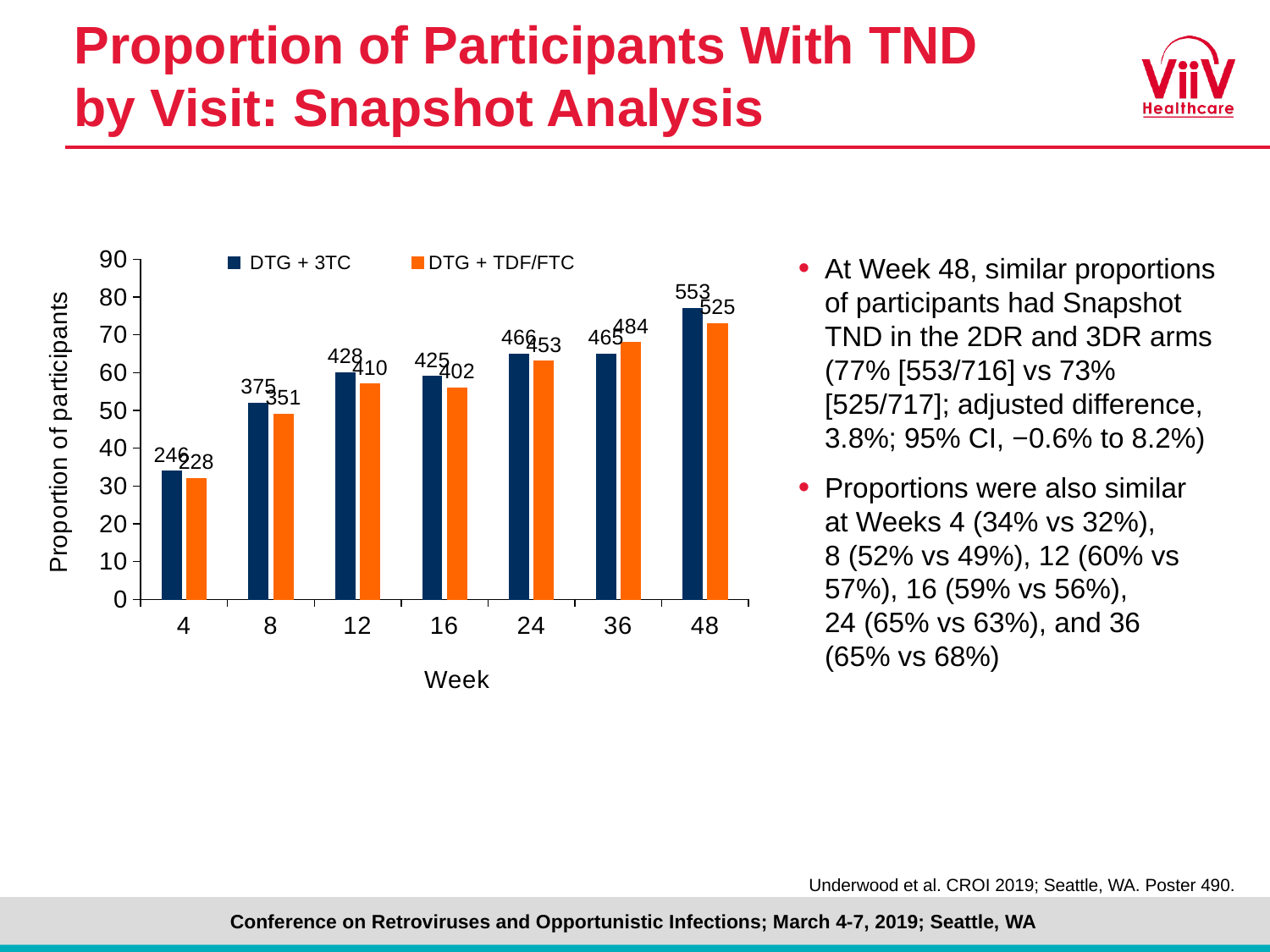
How many week time points are shown on the x axis of the chart? 7 What data label is printed on the DTG + TDF/FTC bar at Week 4? 228 How many series does the chart legend list? 2 Is the DTG + 3TC bar at Week 48 greater or less than 70 on the y axis? greater At Week 36, which series has the larger data label, DTG + 3TC or DTG + TDF/FTC? DTG + TDF/FTC Do the DTG + 3TC bars generally rise or fall from Week 4 to Week 48? Rise What data label is printed on the DTG + TDF/FTC bar at Week 36? 484 What data label is printed on the DTG + 3TC bar at Week 48? 553 Is the DTG + TDF/FTC bar at Week 4 greater or less than 40 on the y axis? less What is the difference between the data labels on the DTG + 3TC and DTG + TDF/FTC bars at Week 48? 28 At which week is the DTG + 3TC bar the tallest? 48 What type of chart is shown on the slide? Bar chart